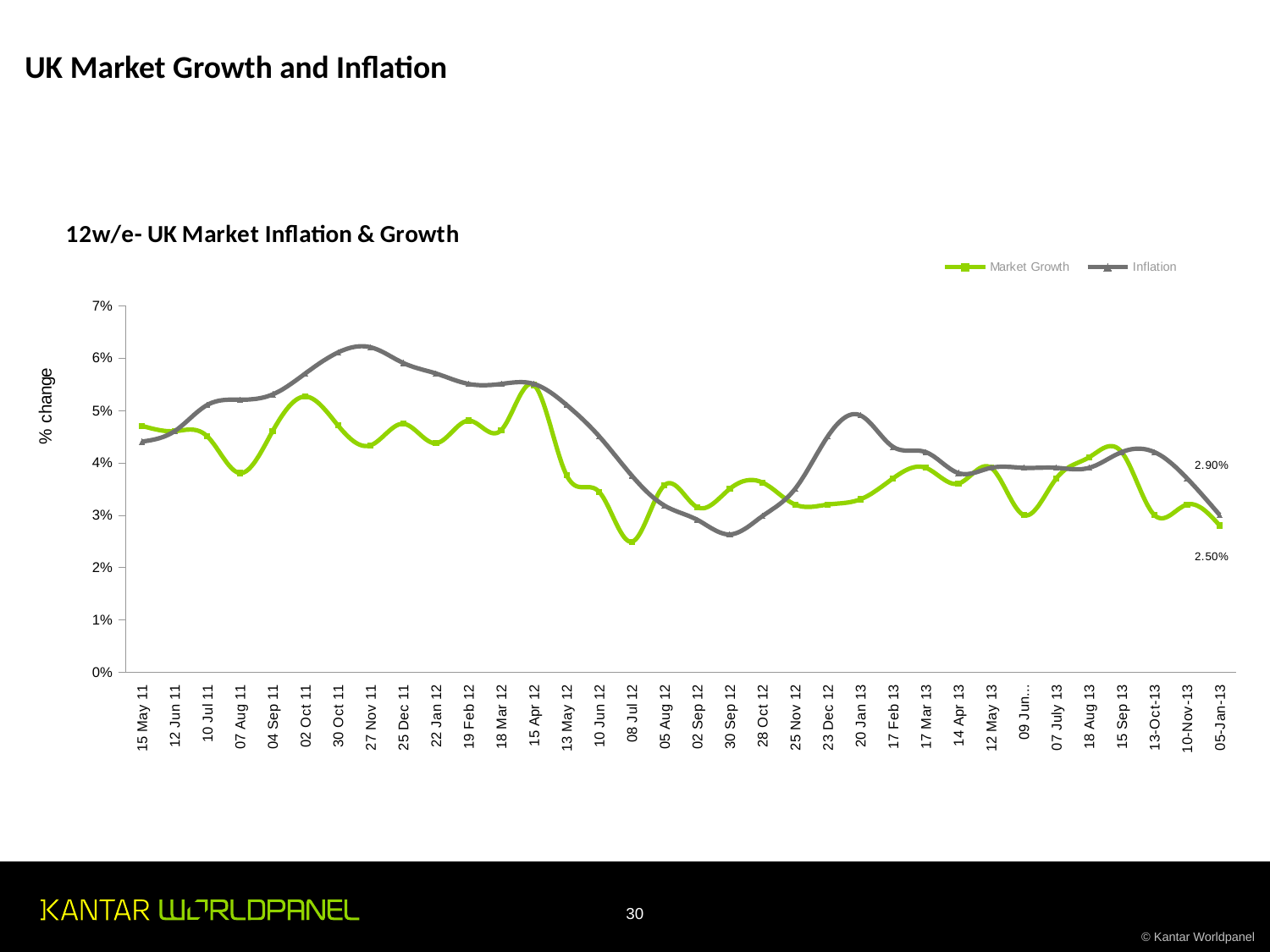
How many series does the legend list? 2 Is the Inflation value at 27 Nov 11 greater or less than 6%? greater Is the Market Growth value at 08 Jul 12 greater or less than 3%? less At 20 Jan 13, which series has the higher value, Market Growth or Inflation? Inflation What type of chart is shown on the slide? Line chart What is the Inflation value labelled at the final point, 05-Jan-13? 2.90% At which date does Inflation reach its lowest value? 30 Sep 12 What are the two series named in the legend? Market Growth and Inflation At which date does Inflation reach its highest value? 27 Nov 11 What is the Market Growth value labelled at the final point, 05-Jan-13? 2.50% What is the title of the chart? 12w/e- UK Market Inflation & Growth How many dates are shown on the x axis? 34